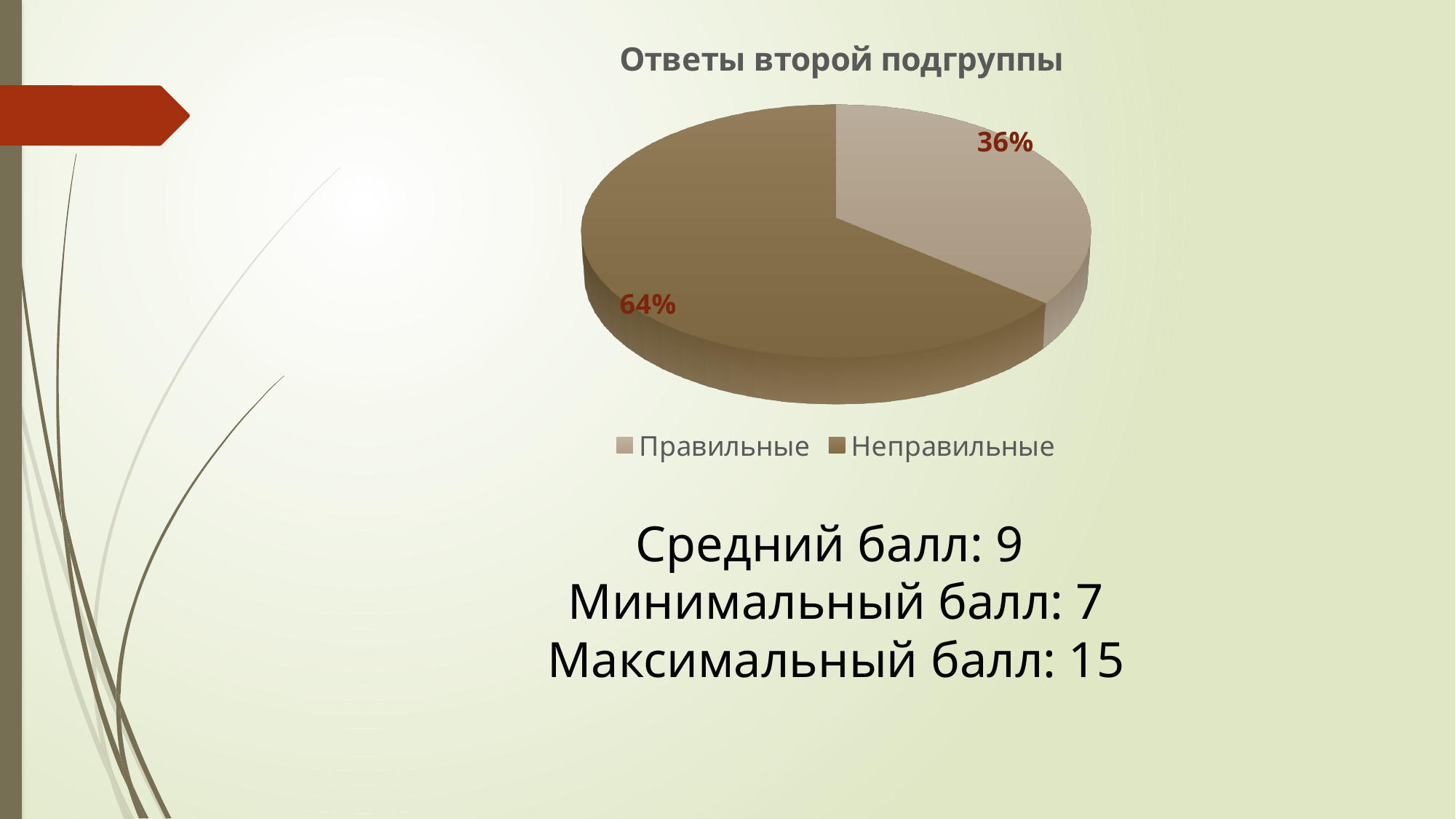
Which legend entry is shown in the darker brown colour? Неправильные How many entries does the legend list? 2 Which slice is the largest? Неправильные How many slices does the pie chart have? 2 Which slice is the smallest? Правильные What is the difference in percentage points between Неправильные and Правильные? 28% What kind of chart is shown on the slide? pie chart Which is larger, Правильные or Неправильные? Неправильные What share of the pie is labelled Неправильные? 64% What share of the pie is labelled Правильные? 36% What is the title of the chart? Ответы второй подгруппы